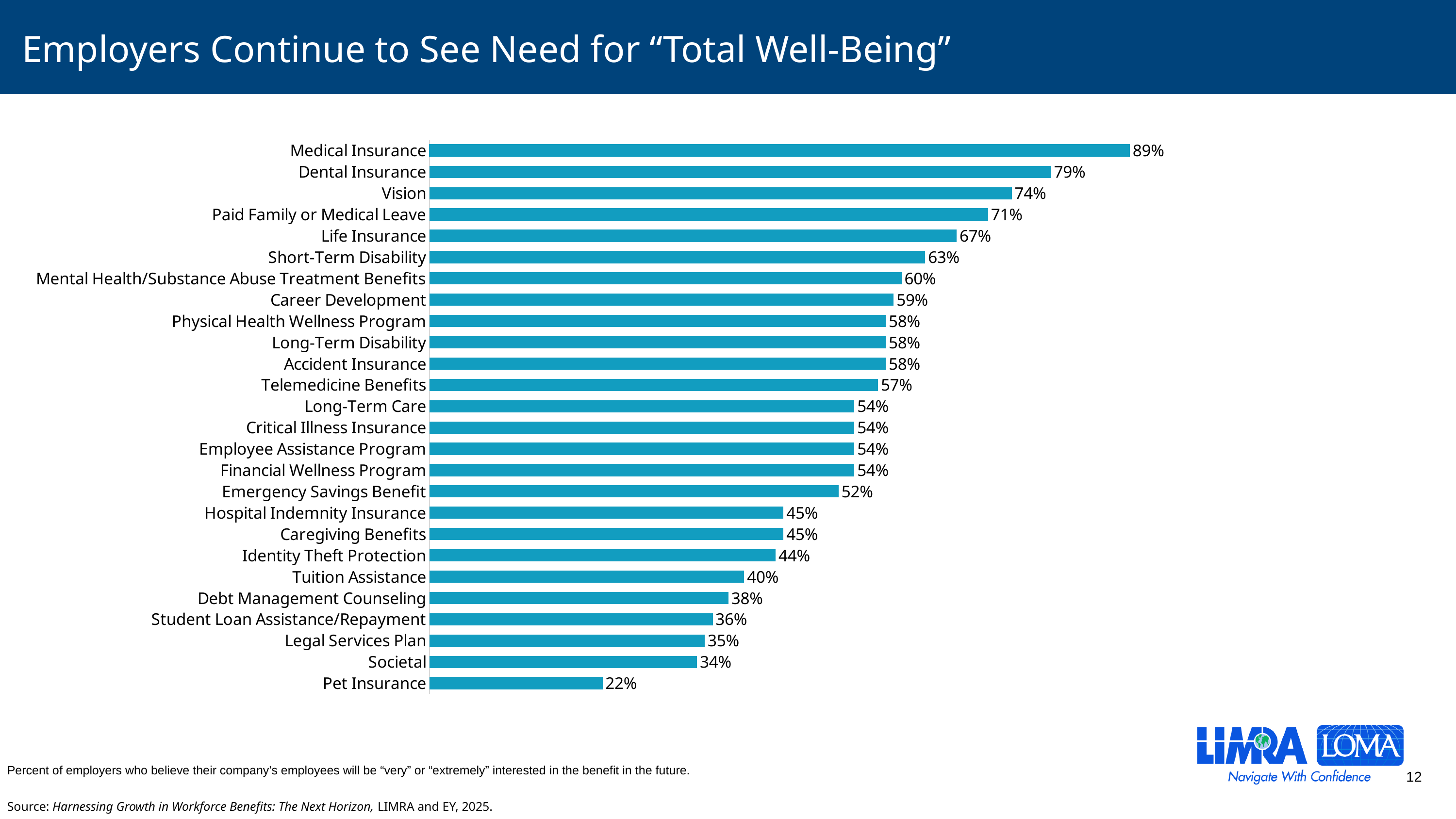
Which benefit has the highest percentage? Medical Insurance Which has a larger value, Life Insurance or Short-Term Disability? Life Insurance What is the difference between the values for Medical Insurance and Dental Insurance? 10% What is the value shown for Mental Health/Substance Abuse Treatment Benefits? 60% What kind of chart is shown on the slide? Bar chart What is the difference between the values for Vision and Societal? 40% What is the value shown for Tuition Assistance? 40% Which benefit has the lowest percentage? Pet Insurance What percentage of employers believe employees will be very or extremely interested in Medical Insurance? 89% How many benefit categories are shown in the chart? 26 Which has a larger value, Legal Services Plan or Debt Management Counseling? Debt Management Counseling What is the value shown for Pet Insurance? 22%